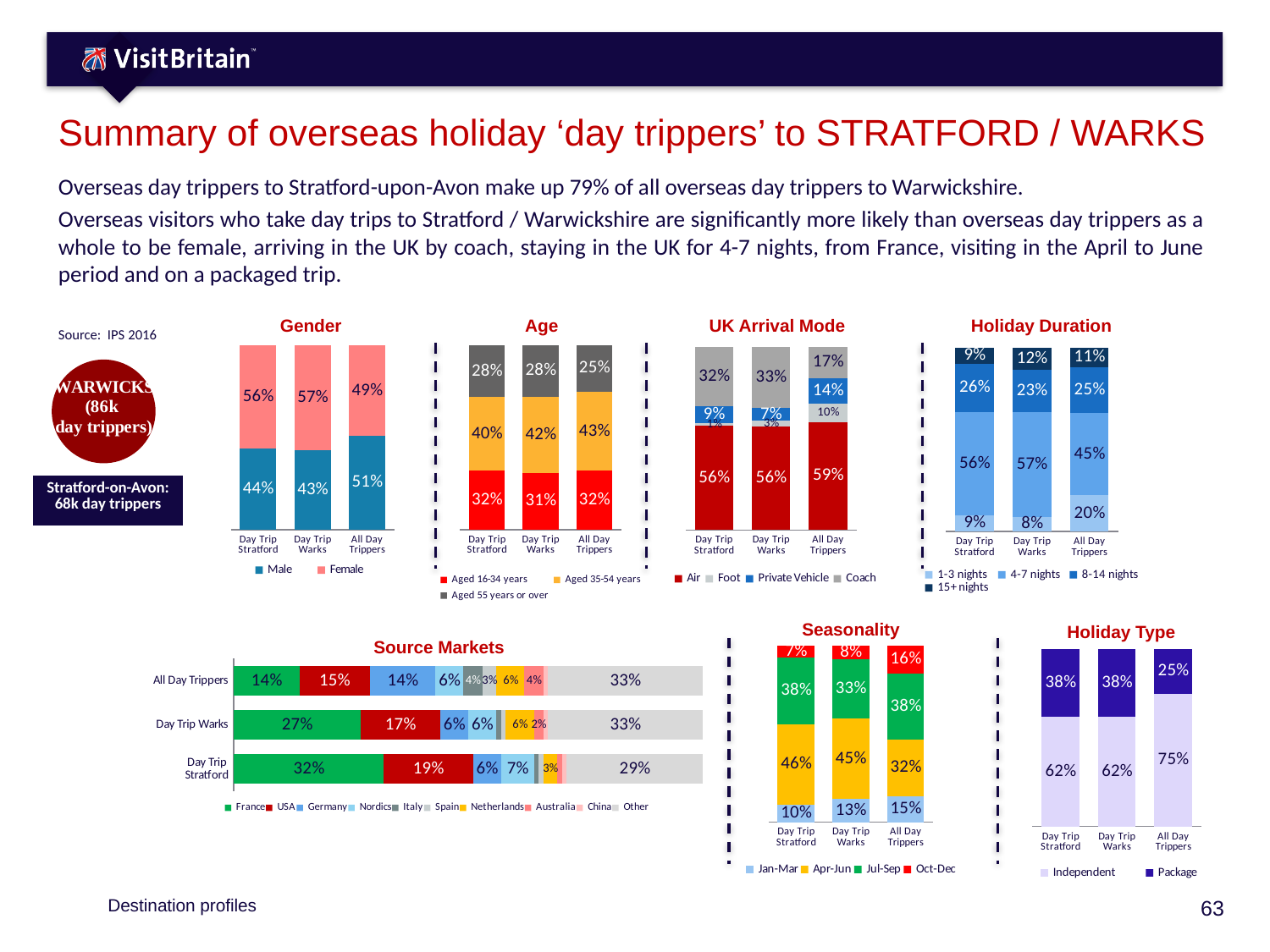
In the Source Markets chart, how many source market series does the legend list? 10 In the UK Arrival Mode chart, what is the difference between the coach share for Day Trip Warks and for All Day Trippers? 16 percentage points In the Gender chart, what percentage of All Day Trippers are male? 51% In the Seasonality chart, what share of Day Trip Stratford visits occur in Apr-Jun? 46% In the Age chart, what share of Day Trip Warks visitors are aged 35-54 years? 42% In the Holiday Duration chart, what percentage of All Day Trippers stay 1-3 nights? 20% In the Gender chart, what percentage of Day Trip Stratford visitors are female? 56% In the Holiday Type chart, what percentage of All Day Trippers are on a package trip? 25% In the Holiday Duration chart, which category has the highest share of 4-7 nights stays? Day Trip Warks In the UK Arrival Mode chart, what percentage of Day Trip Stratford visitors arrive by coach? 32% In the Seasonality chart, is the Jul-Sep share larger for Day Trip Stratford or for Day Trip Warks? Day Trip Stratford In the Source Markets chart, what percentage of Day Trip Stratford visitors come from France? 32%